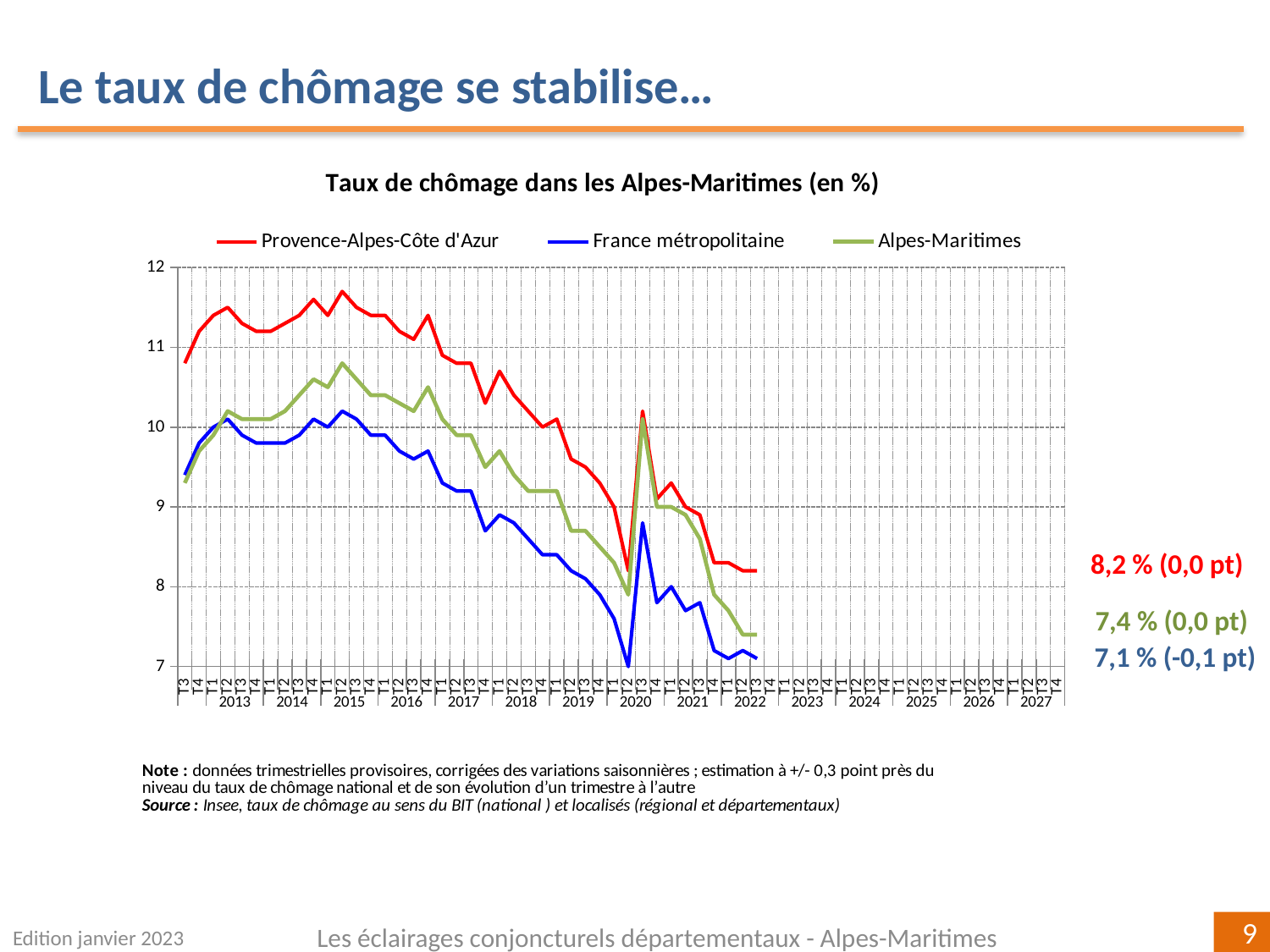
Overall, do the unemployment rates rise or fall between 2015 and 2022? fall Is the peak value for Provence-Alpes-Côte d'Azur in 2015 greater or less than 11? greater What kind of chart is shown on the slide? line chart Is the value for France métropolitaine at its 2020 spike (T3 2020) greater or less than 9? less Which series has the highest value at the end of the plotted period? Provence-Alpes-Côte d'Azur What is the title of the chart? Taux de chômage dans les Alpes-Maritimes (en %) What is the latest unemployment rate shown for Provence-Alpes-Côte d'Azur? 8,2 % Which series has the lowest value at the end of the plotted period? France métropolitaine What is the latest unemployment rate shown for France métropolitaine? 7,1 % What is the difference between the latest values for Provence-Alpes-Côte d'Azur and France métropolitaine, in points? 1,1 What is the latest unemployment rate shown for Alpes-Maritimes? 7,4 % How many series does the legend list? 3